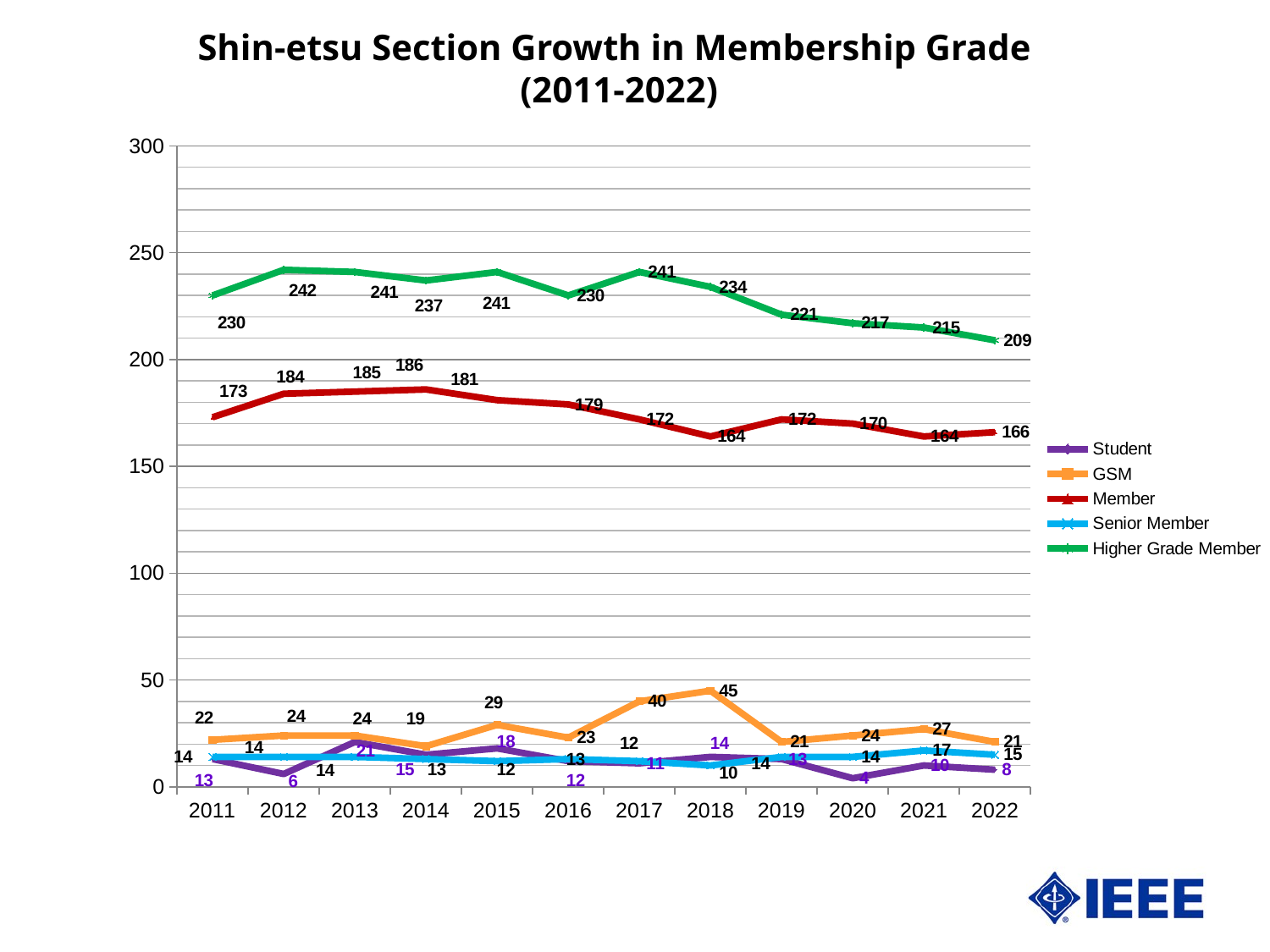
How many series does the legend list? 5 What is the GSM value for 2017? 40 What is the Member value for 2011? 173 In which year is the Higher Grade Member series at its highest? 2012 What kind of chart is shown on the slide? line chart Does the Higher Grade Member series rise or fall from 2017 to 2022? fall In which year is the GSM series at its highest? 2018 Which year has the larger Member value, 2012 or 2018? 2012 What is the difference between the Higher Grade Member values for 2011 and 2022? 21 How many years are plotted along the x axis? 12 What is the Higher Grade Member value for 2022? 209 What is the difference between the Member values for 2014 and 2022? 20